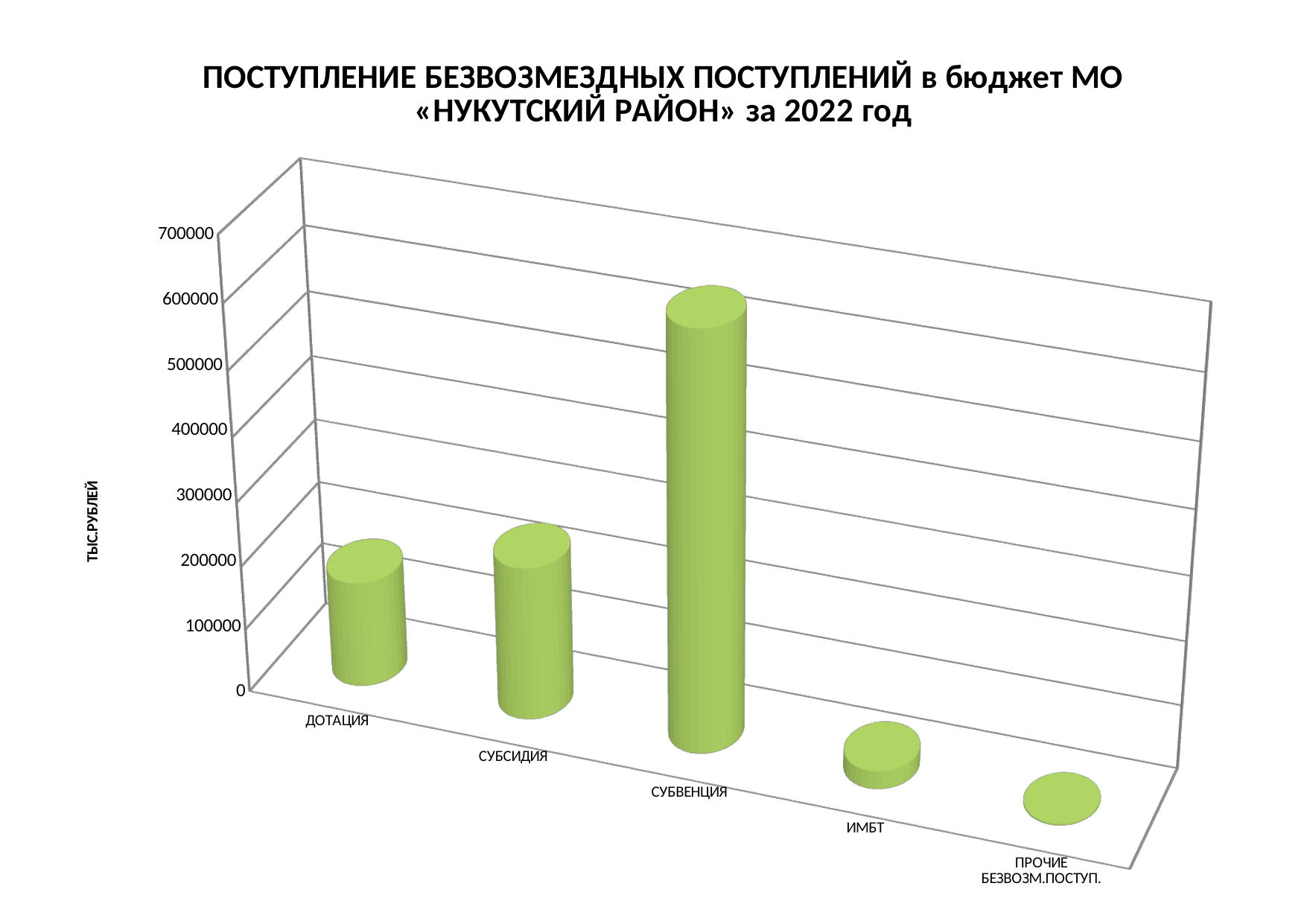
Is the value for ДОТАЦИЯ greater or less than 100000? greater Which category has the lowest value? ПРОЧИЕ БЕЗВОЗМ.ПОСТУП. How many categories are plotted on the chart? 5 Which category has the highest value? СУБВЕНЦИЯ Is the value for ИМБТ greater or less than 100000? less Which is larger, the value for СУБВЕНЦИЯ or the value for ДОТАЦИЯ? СУБВЕНЦИЯ What is the title of the vertical axis? ТЫС.РУБЛЕЙ Is the value for СУБВЕНЦИЯ greater or less than 400000? greater Which is larger, the value for СУБСИДИЯ or the value for ИМБТ? СУБСИДИЯ What is the highest tick value shown on the vertical axis? 700000 What kind of chart is shown on the slide? bar chart